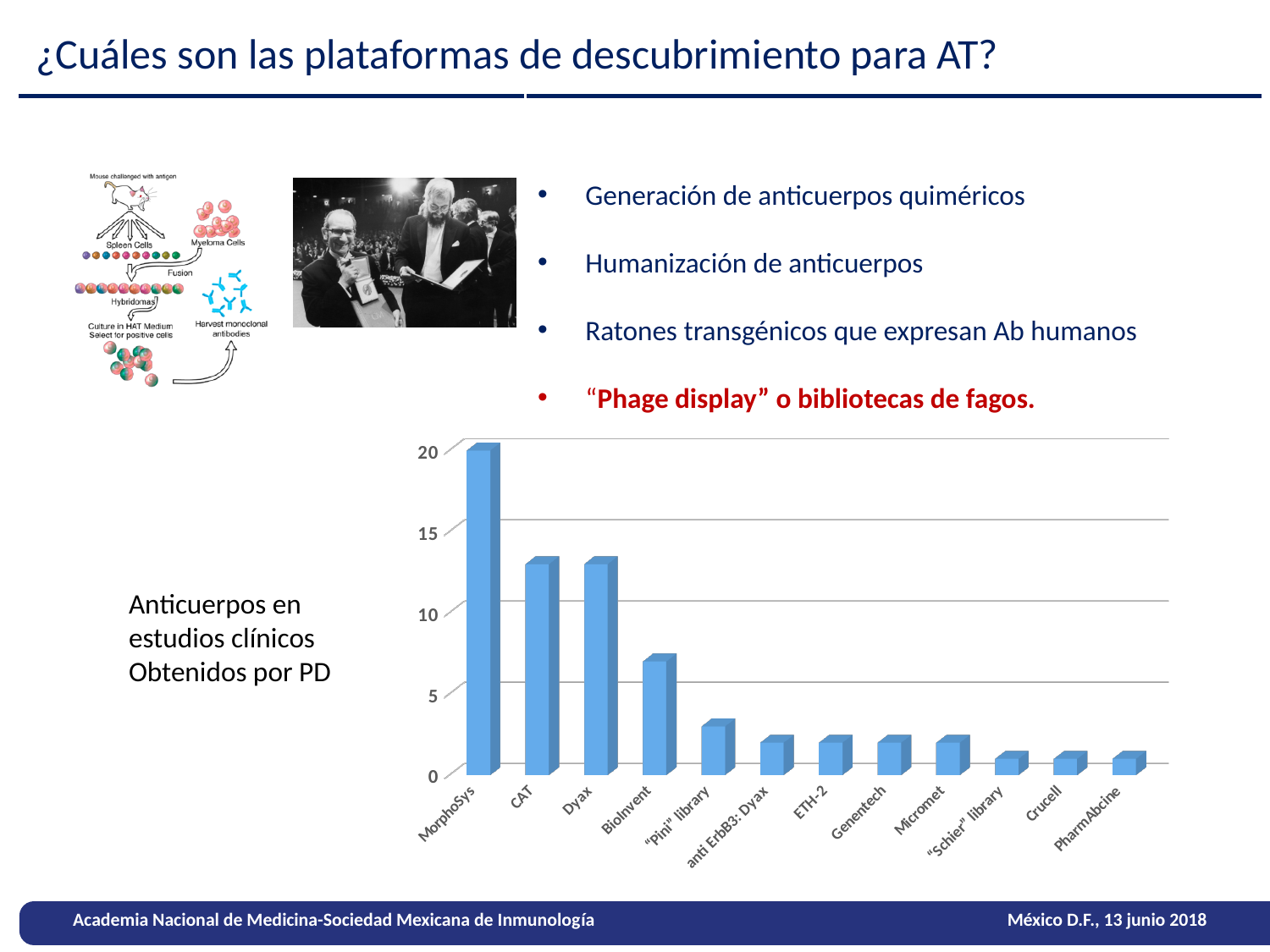
How many categories are shown on the x axis of the bar chart? 12 Is the value for CAT greater or less than 10? greater Is the value for Genentech greater or less than 5? less Do the bar values generally rise or fall from left to right along the x axis? fall Which is larger, the value for MorphoSys or the value for CAT? MorphoSys Is the value for BioInvent greater or less than 10? less What kind of chart is shown on the slide? bar chart Which category has the highest bar in the chart? MorphoSys What is the first category listed on the x axis of the chart? MorphoSys Which is larger, the value for BioInvent or the value for ETH-2? BioInvent